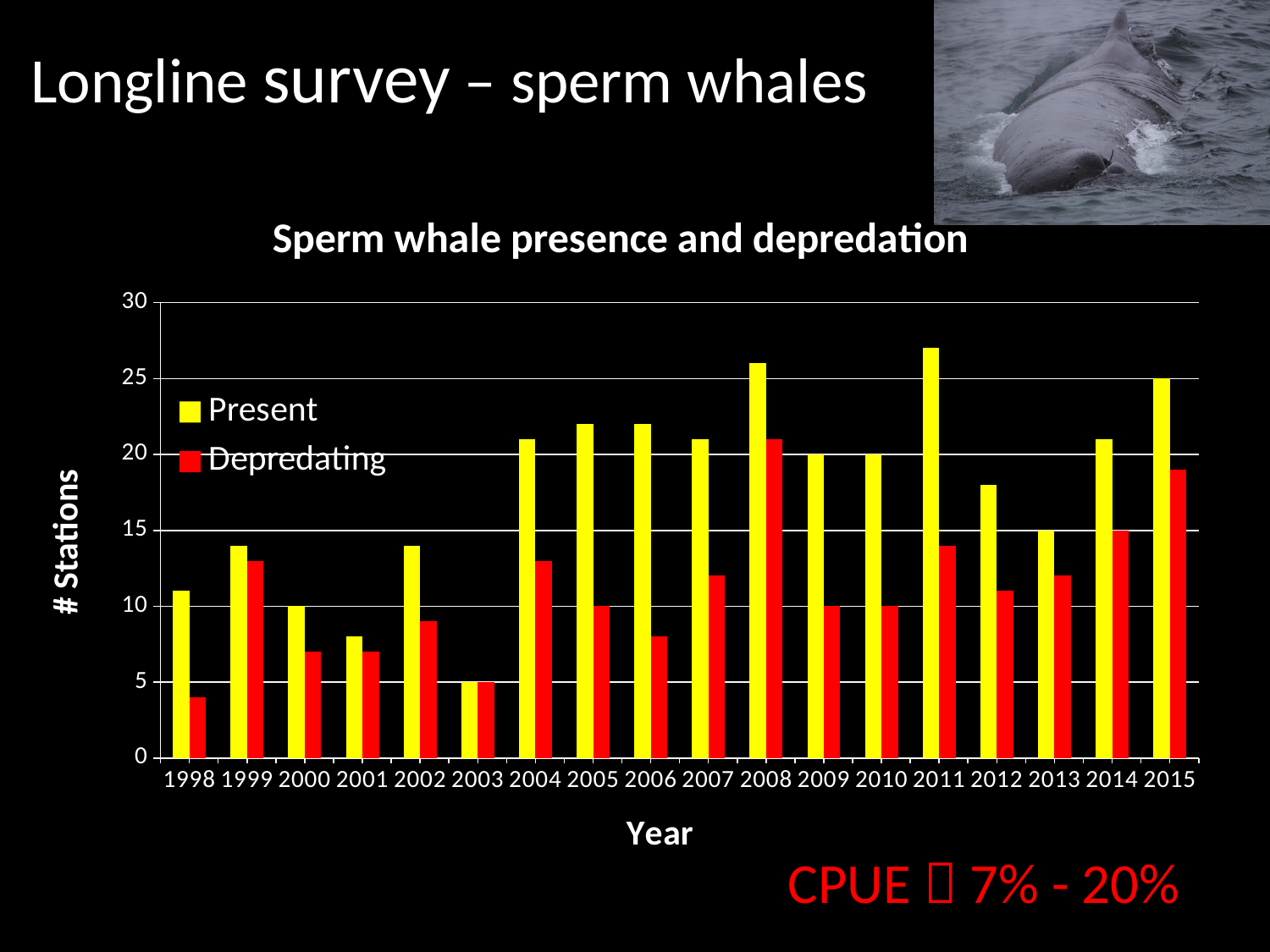
What type of chart is shown on the slide? bar chart Which is larger, the Present value for 2008 or the Present value for 2012? 2008 What is the Present value for 2015? 25 Which year has the highest Depredating value? 2008 How many years are shown on the x axis? 18 What is the Present value for 2003? 5 How many series does the legend list? 2 What is the Depredating value for 2014? 15 What is the title of the chart? Sperm whale presence and depredation Is the Present value for 2008 greater or less than 25? greater Which year has the lowest Present value? 2003 What is the label of the vertical axis? # Stations